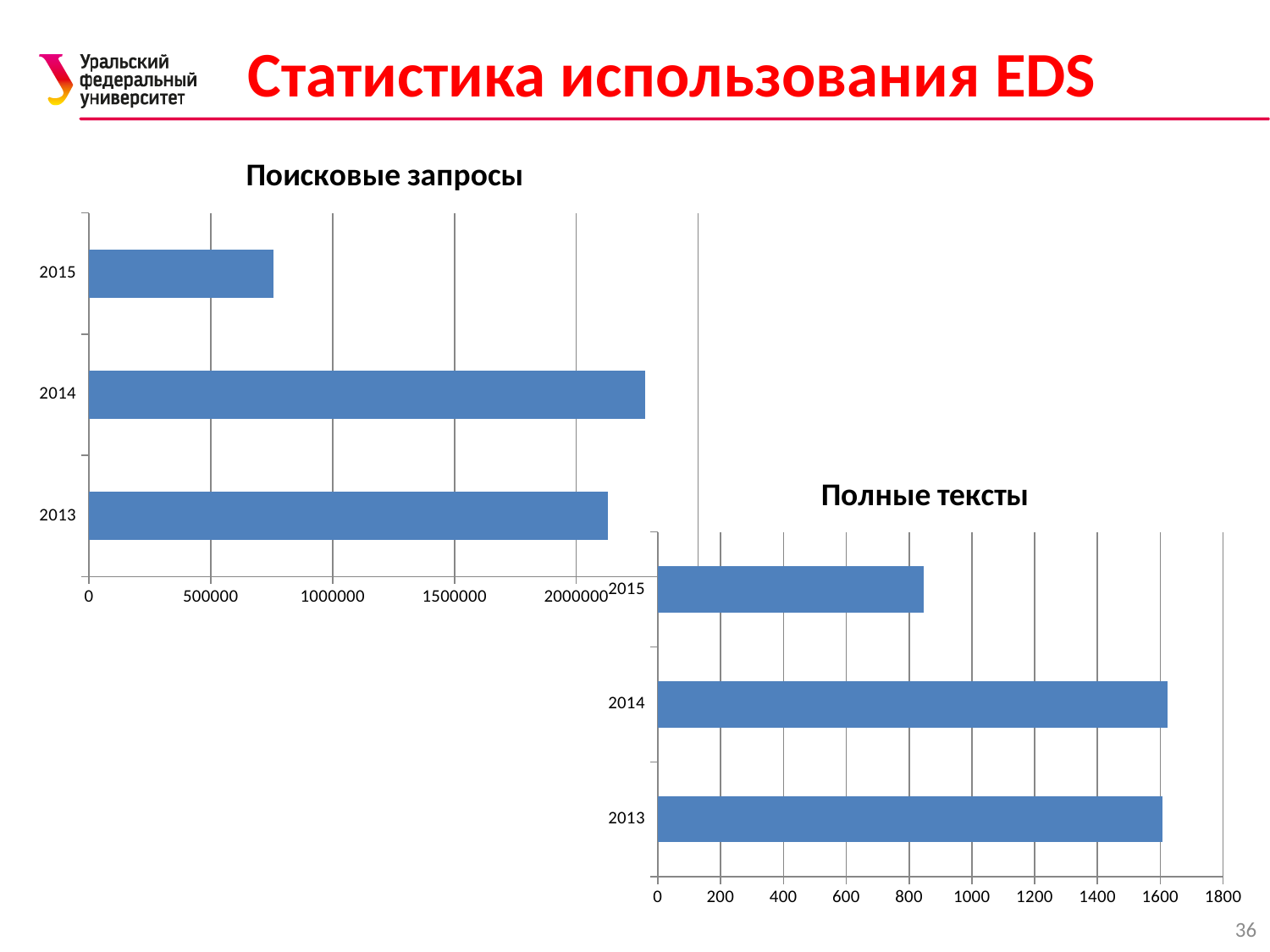
In the "Поисковые запросы" chart, is the value for 2015 greater or less than 1000000? less What kind of chart is the "Полные тексты" chart? bar chart In the "Поисковые запросы" chart, is the value for 2014 greater or less than 2000000? greater In the "Поисковые запросы" chart, which is larger, the value for 2014 or the value for 2015? 2014 What kind of chart is the "Поисковые запросы" chart? bar chart In the "Полные тексты" chart, is the value for 2014 greater or less than 1400? greater How many categories (years) does the "Поисковые запросы" chart show? 3 In the "Полные тексты" chart, which year has the lowest value? 2015 How many categories (years) does the "Полные тексты" chart show? 3 What is the title of the chart on the right side of the slide? Полные тексты In the "Поисковые запросы" chart, which year has the lowest value? 2015